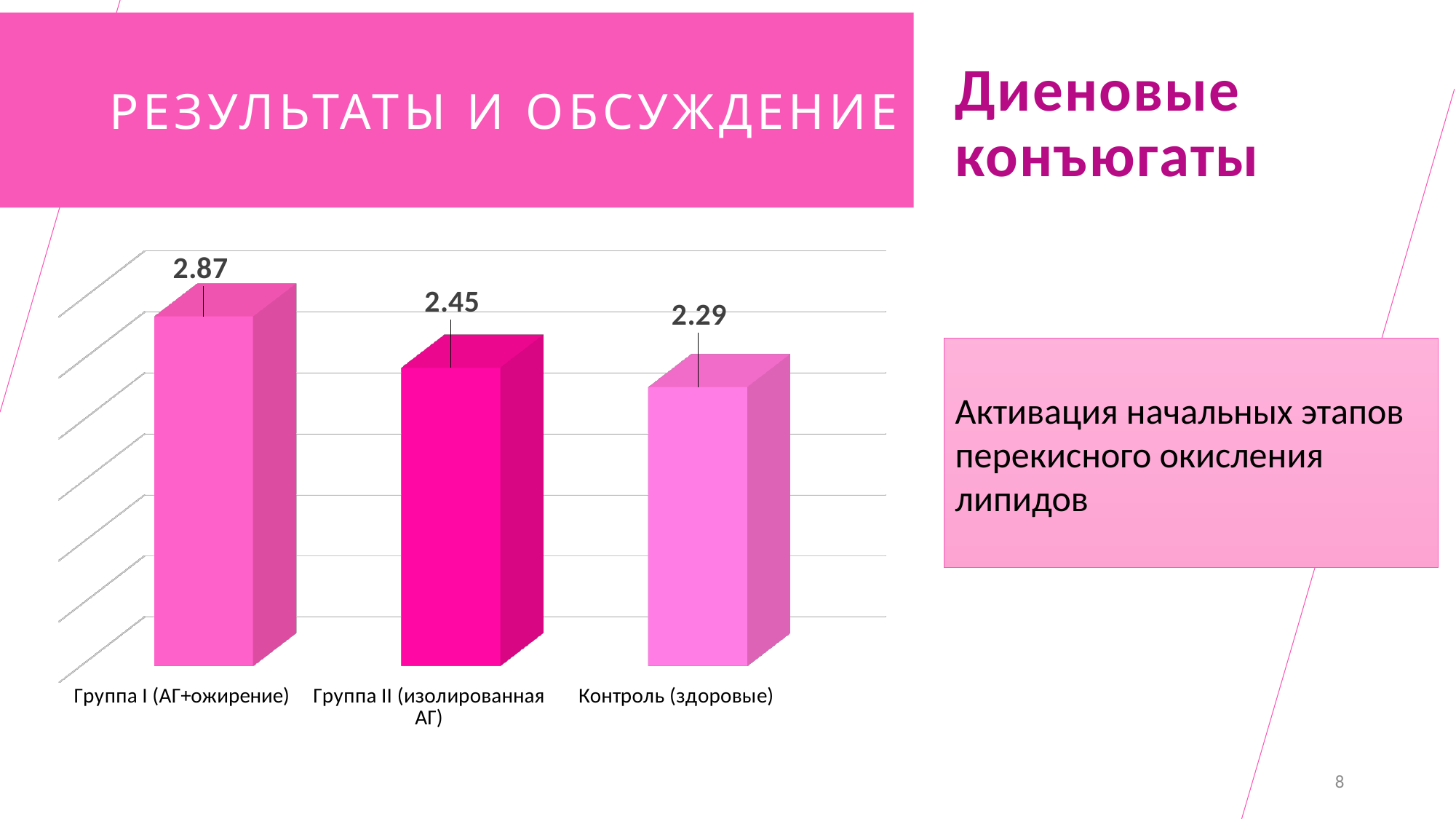
What is the value for Группа I (АГ+ожирение)? 2.87 Which category has the lowest value? Контроль (здоровые) What is the value for Группа II (изолированная АГ)? 2.45 Which is larger, the value for Группа II (изолированная АГ) or Контроль (здоровые)? Группа II (изолированная АГ) What kind of chart is shown on the slide? bar chart What is the difference between the values for Группа I (АГ+ожирение) and Группа II (изолированная АГ)? 0.42 What is the heading next to the chart on the right side of the slide? Диеновые конъюгаты What is the difference between the values for Группа I (АГ+ожирение) and Контроль (здоровые)? 0.58 Do the values rise or fall from left to right across the categories? fall How many categories are shown in the chart? 3 What is the value for Контроль (здоровые)? 2.29 Which category has the highest value? Группа I (АГ+ожирение)